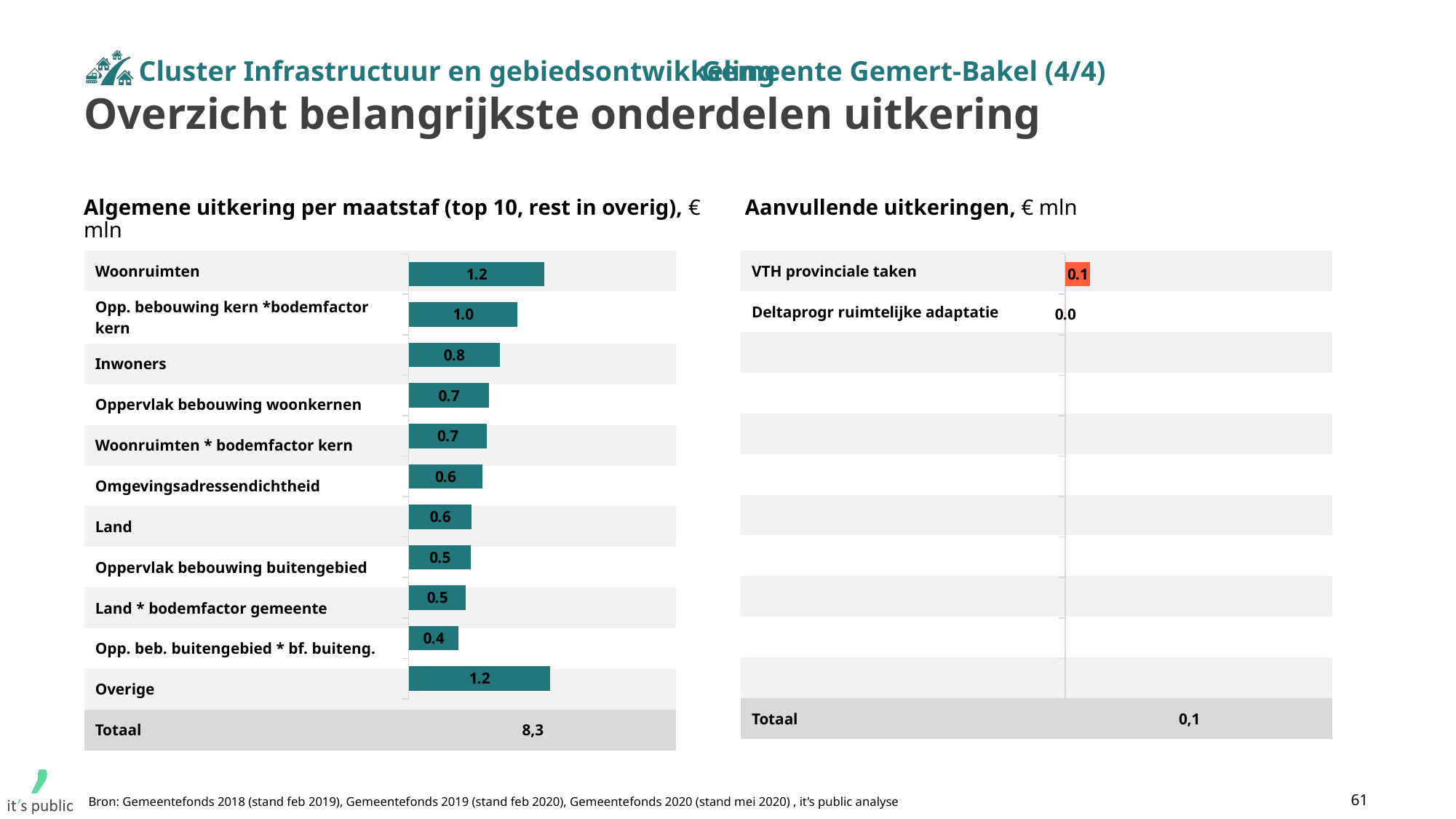
In the chart 'Algemene uitkering per maatstaf', what is the value for Inwoners? 0.8 In the chart 'Algemene uitkering per maatstaf', which is larger: the value for Land or the value for Opp. beb. buitengebied * bf. buiteng.? Land What kind of chart is 'Algemene uitkering per maatstaf'? Bar chart In the chart 'Algemene uitkering per maatstaf', what is the value for Omgevingsadressendichtheid? 0.6 In the chart 'Algemene uitkering per maatstaf', which category has the lowest value? Opp. beb. buitengebied * bf. buiteng. In the chart 'Algemene uitkering per maatstaf', what is the value for Overige? 1.2 In the chart 'Algemene uitkering per maatstaf', what is the value for Woonruimten? 1.2 In the chart 'Algemene uitkering per maatstaf', what is the difference between the values for Woonruimten and Inwoners? 0.4 In the chart 'Aanvullende uitkeringen', what is the value for VTH provinciale taken? 0.1 In the chart 'Algemene uitkering per maatstaf', how many categories are shown as bars? 11 In the chart 'Algemene uitkering per maatstaf', what is the Totaal shown at the bottom? 8,3 In the chart 'Aanvullende uitkeringen', what is the value for Deltaprogr ruimtelijke adaptatie? 0.0